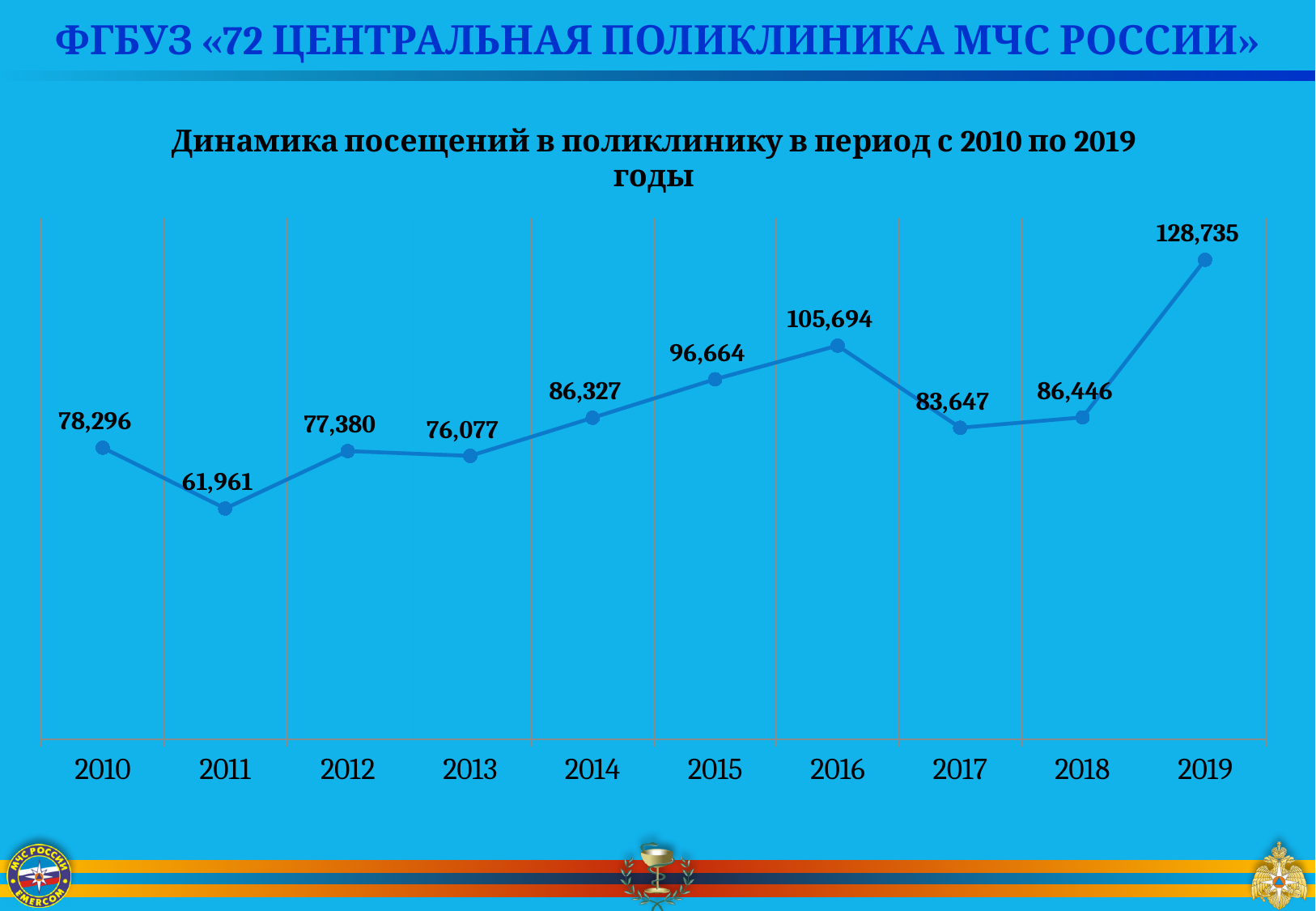
What is the number of visits in 2018? 86,446 What is the number of visits in 2016? 105,694 What is the difference between the number of visits in 2019 and in 2016? 23,041 How many years are plotted on the chart? 10 What kind of chart is shown on the slide? Line chart By how much did the number of visits fall from 2010 to 2011? 16,335 Which year had more visits, 2012 or 2013? 2012 Which year had more visits, 2017 or 2015? 2015 Do the number of visits rise or fall from 2013 to 2016? Rise Which year has the highest number of visits? 2019 What is the number of visits in 2011? 61,961 Which year has the lowest number of visits? 2011